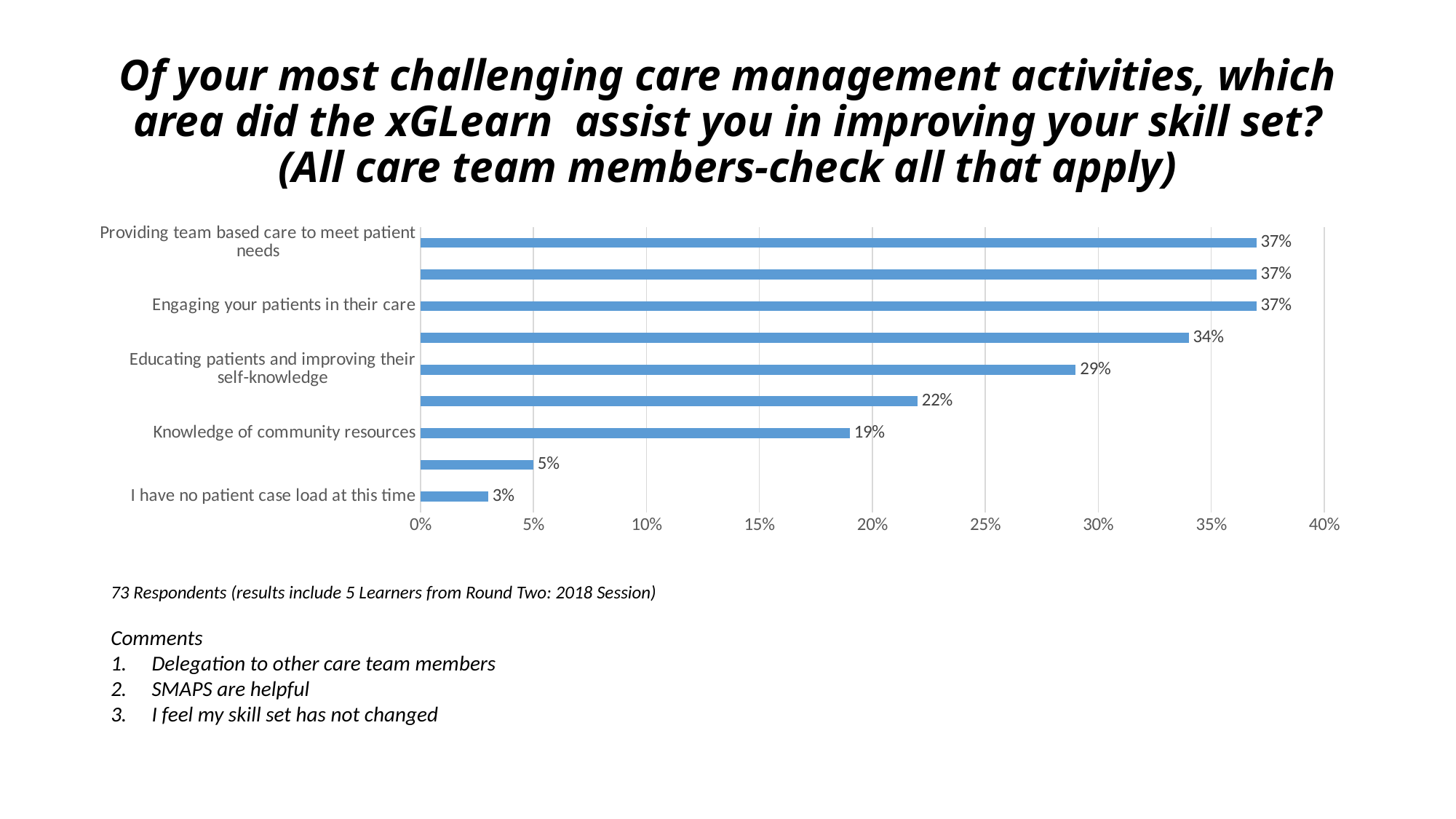
What is the difference between the percentages for "Providing team based care to meet patient needs" and "Educating patients and improving their self-knowledge"? 8% What percentage is shown for "Educating patients and improving their self-knowledge"? 29% What percentage is shown for "Knowledge of community resources"? 19% What kind of chart is shown on the slide? bar chart What is the difference between the percentages for "Educating patients and improving their self-knowledge" and "Knowledge of community resources"? 10% Is the value for "Knowledge of community resources" greater or less than 20%? less What percentage is shown for "I have no patient case load at this time"? 3% How many bars are plotted in the chart? 9 Which labeled category has the lowest percentage? I have no patient case load at this time Which has a higher percentage: "Educating patients and improving their self-knowledge" or "Knowledge of community resources"? Educating patients and improving their self-knowledge What percentage is shown for "Engaging your patients in their care"? 37% What percentage is shown for "Providing team based care to meet patient needs"? 37%